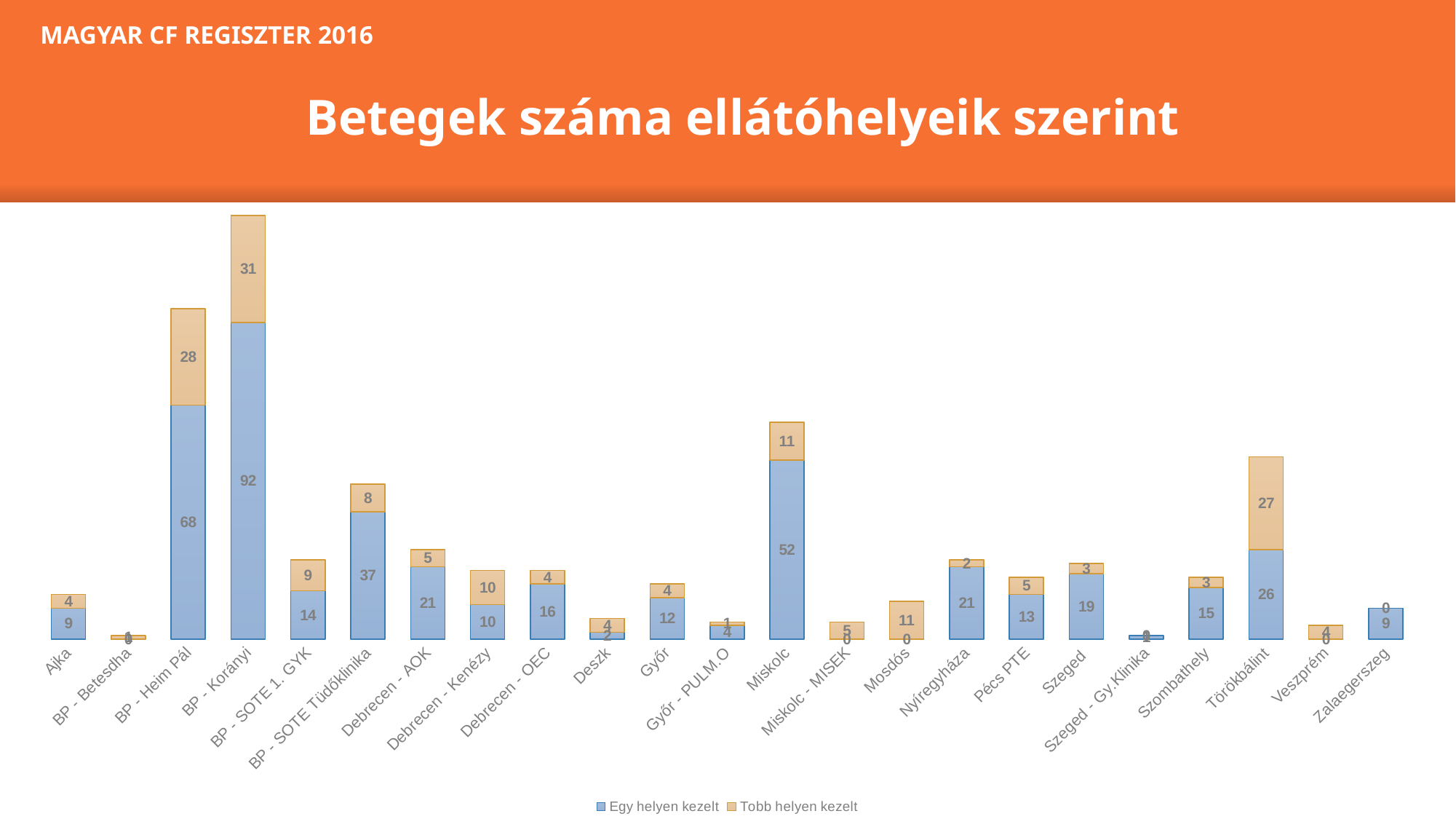
Which category has the highest "Egy helyen kezelt" value? BP - Korányi For Törökbálint, which series has the larger value, "Egy helyen kezelt" or "Tobb helyen kezelt"? Tobb helyen kezelt What is the difference between the "Egy helyen kezelt" values for BP - Korányi and BP - Heim Pál? 24 How many series does the legend list? 2 What is the title of the chart? Betegek száma ellátóhelyeik szerint What is the total height of the stacked bar for BP - Heim Pál? 96 What is the value of "Egy helyen kezelt" for BP - Korányi? 92 What is the value of "Tobb helyen kezelt" for BP - Heim Pál? 28 What is the value of "Egy helyen kezelt" for Miskolc? 52 What is the value of "Tobb helyen kezelt" for Törökbálint? 27 What kind of chart is shown on the slide? Stacked bar chart What is the total height of the stacked bar for BP - Korányi? 123